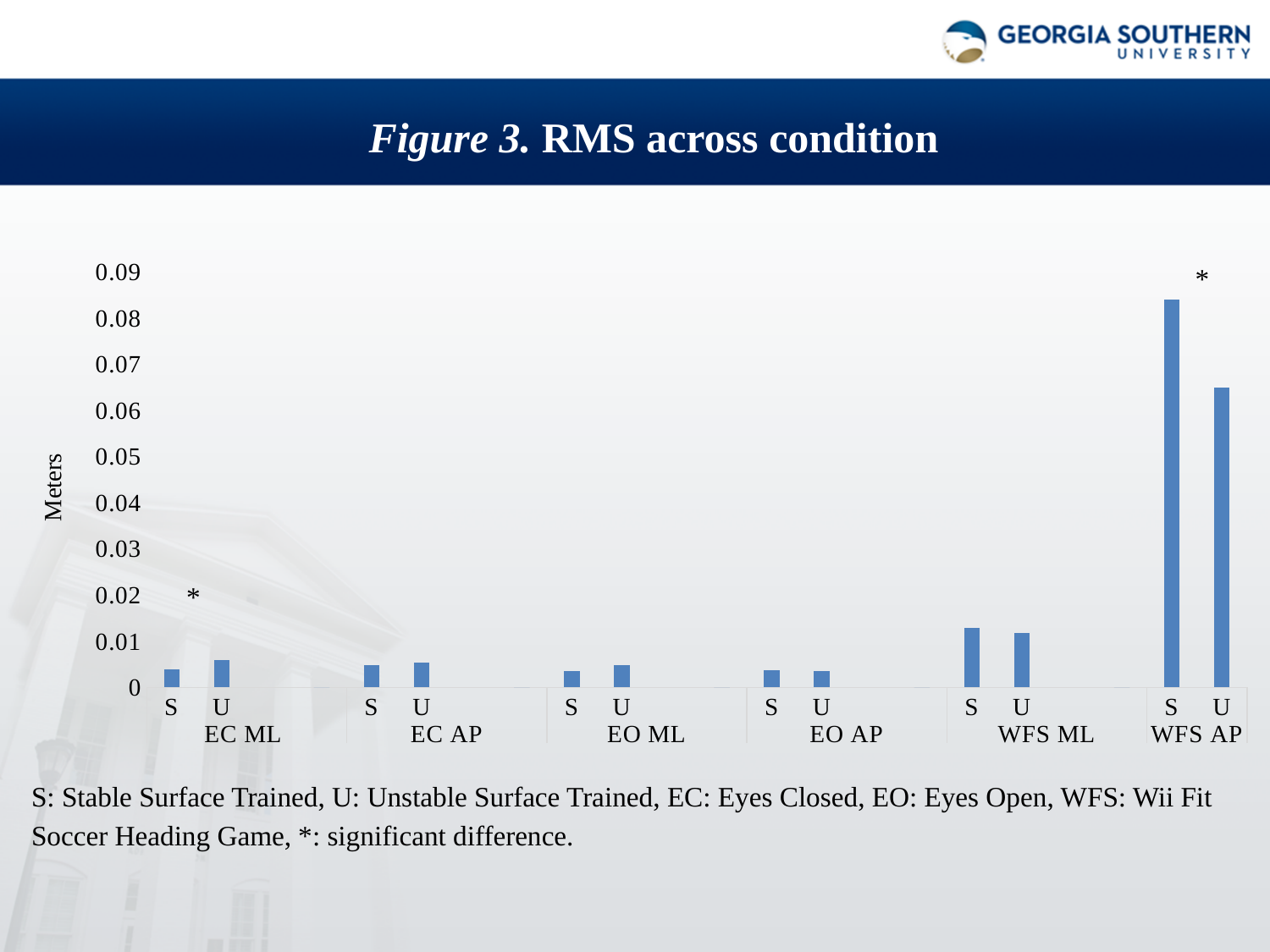
What kind of chart is shown on the slide? bar chart Which is larger, the S bar in WFS ML or the S bar in EC ML? S in WFS ML How many bars are plotted in the chart in total? 12 In the WFS AP group, which bar is larger, S or U? S Is the value for S in EC ML greater or less than 0.01? less Is the value for U in WFS AP greater or less than 0.07? less How many condition groups are shown along the x axis of the chart? 6 Is the value for S in WFS ML greater or less than 0.01? greater What is the label on the y axis of the chart? Meters Which bar has the highest value in the chart? S in WFS AP